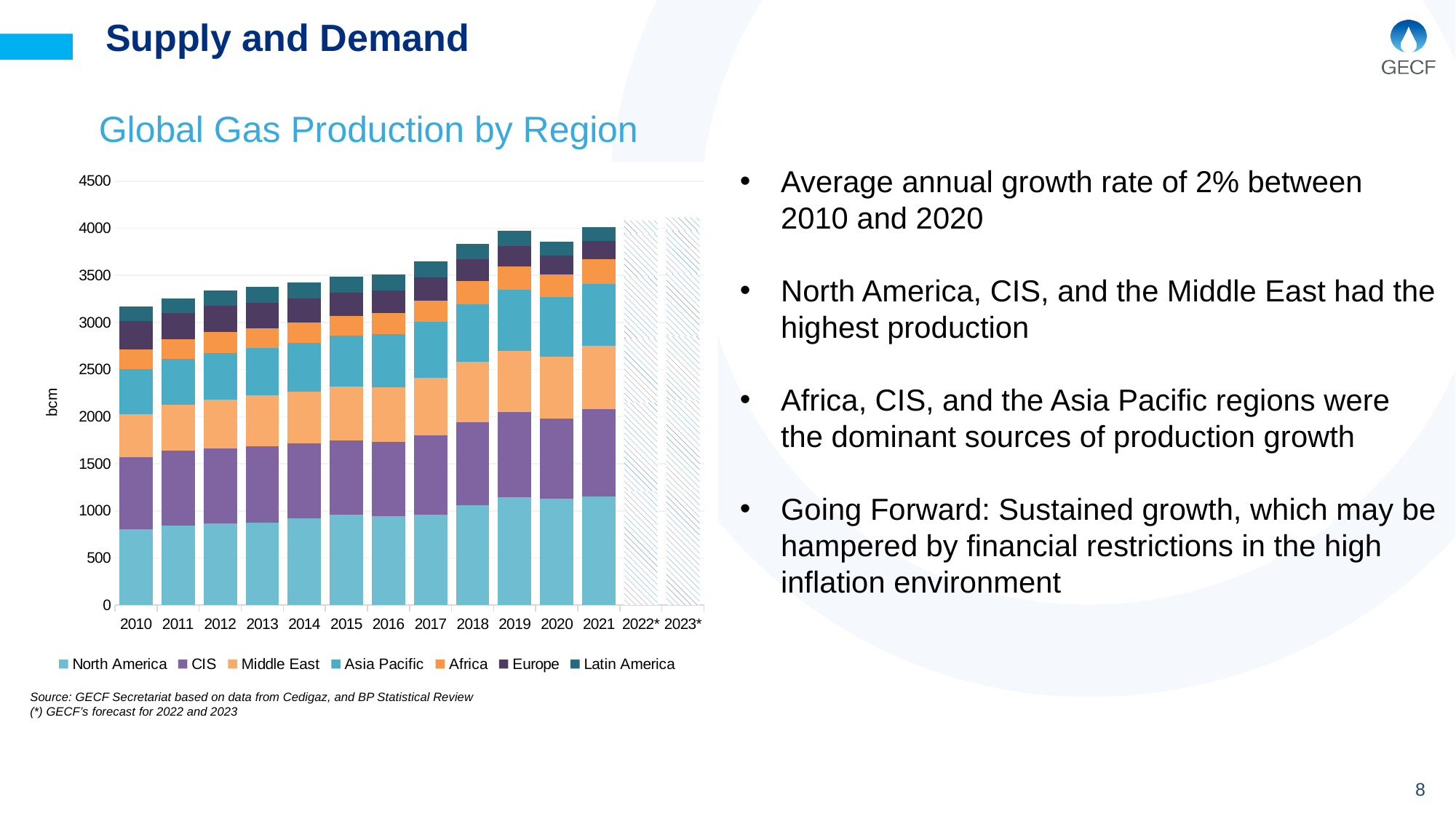
Which year has the lowest total production in the chart? 2010 What is the title of the chart? Global Gas Production by Region Is the total production for 2018 greater or less than 3500? greater Is the total production for 2010 greater or less than 3000? greater What kind of chart is shown on the slide? Stacked bar chart Does total gas production generally rise or fall from 2010 to 2021? Rise Is the North America value for 2010 greater or less than 1000? less How many series does the legend of the Global Gas Production by Region chart list? 7 What unit is shown on the y axis of the chart? bcm How many years are shown on the x axis of the Global Gas Production by Region chart? 14